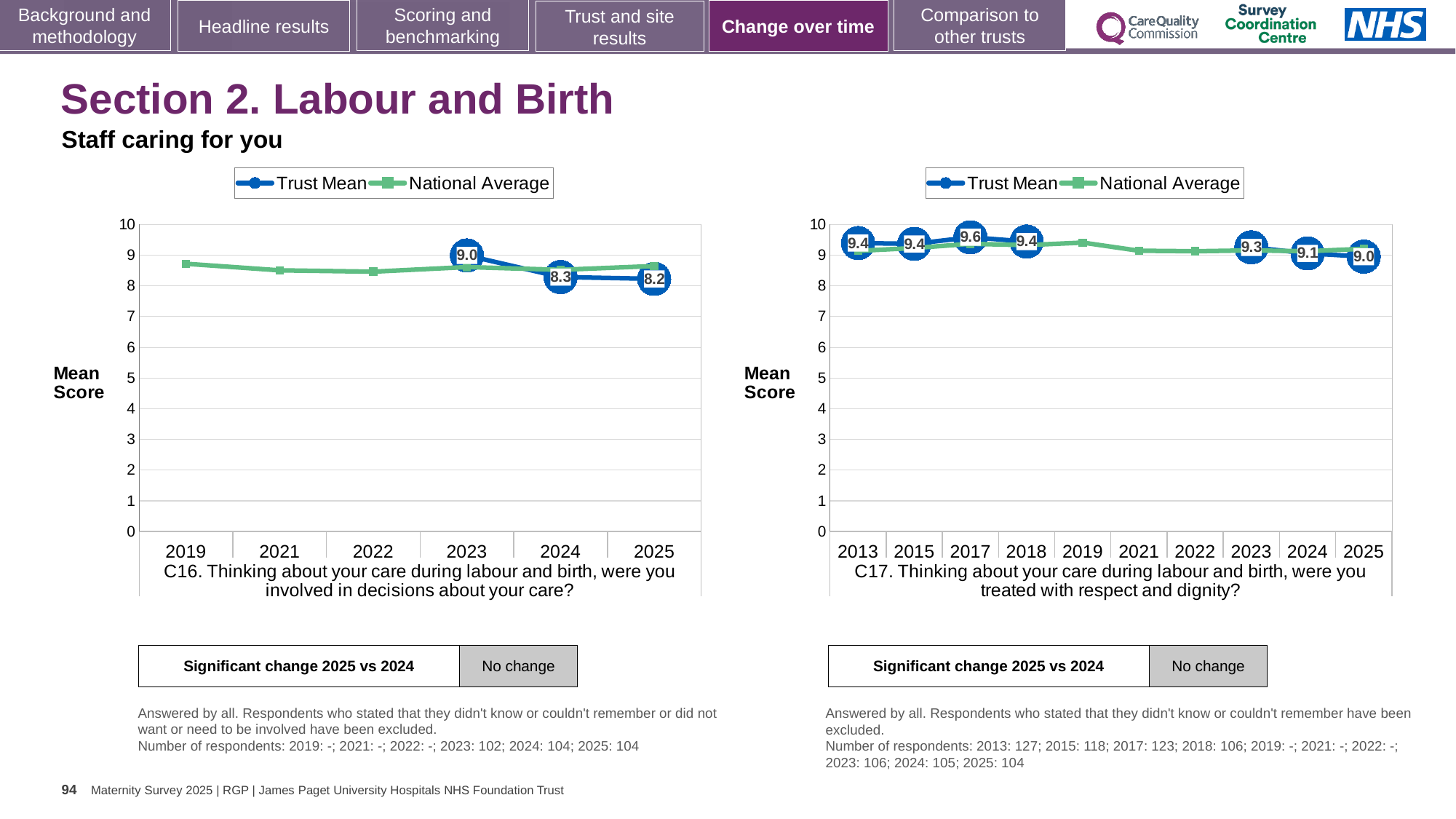
In the C17 chart on the right, which year has the lowest Trust Mean score? 2025 In the C17 chart on the right, how many years are shown on the x axis? 10 In the C16 chart on the left, is the National Average for 2019 greater or less than 8? greater In the C17 chart on the right, which is larger, the Trust Mean for 2018 or for 2024? 2018 What kind of chart is the C17 chart on the right? line chart In the C16 chart on the left, what is the Trust Mean score for 2023? 9.0 In the C16 chart on the left, what is the Trust Mean score for 2025? 8.2 In the C17 chart on the right, what is the Trust Mean score for 2017? 9.6 In the C17 chart on the right, which year has the highest Trust Mean score? 2017 In the C16 chart on the left, does the Trust Mean rise or fall from 2023 to 2025? fall How many series does the legend of the C16 chart on the left list? 2 In the C16 chart on the left, what is the difference between the Trust Mean scores for 2023 and 2025? 0.8